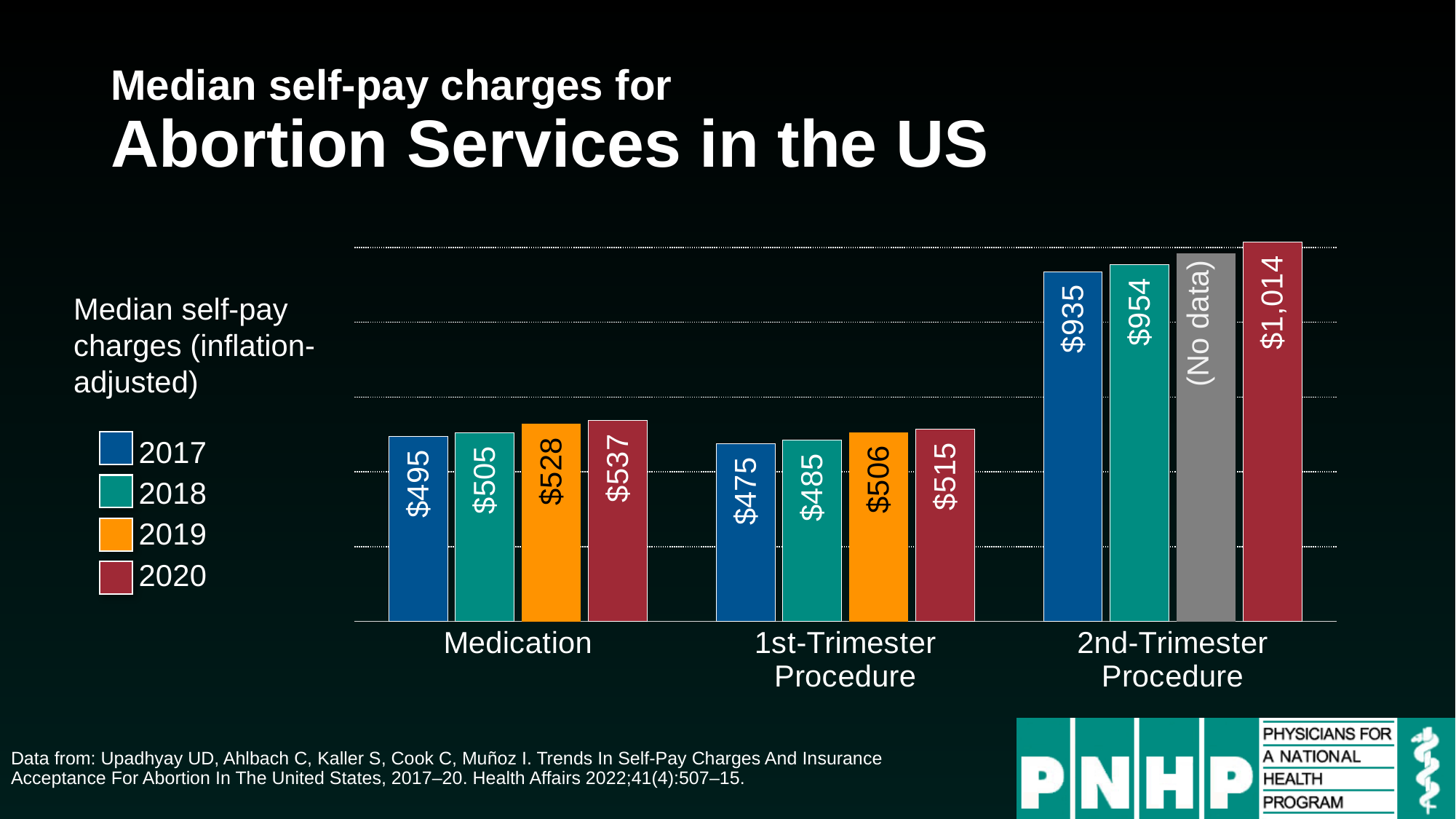
How much did the median self-pay charge for a Medication abortion increase from 2017 to 2020? $42 What is shown for the 2nd-Trimester Procedure in 2019? (No data) What was the median self-pay charge for a 2nd-Trimester Procedure in 2020? $1,014 Which was larger in 2019: the median charge for Medication or for a 1st-Trimester Procedure? Medication What is the difference between the 2018 median charges for a 2nd-Trimester Procedure and a 1st-Trimester Procedure? $469 How many years does the legend list? 4 Which procedure category has the lowest median self-pay charge in 2020? 1st-Trimester Procedure What was the median self-pay charge for a 1st-Trimester Procedure in 2019? $506 Which procedure category has the highest median self-pay charge in 2018? 2nd-Trimester Procedure Do the median self-pay charges for a 1st-Trimester Procedure rise or fall from 2017 to 2020? Rise What was the median self-pay charge for a Medication abortion in 2017? $495 What type of chart is shown on the slide? Bar chart